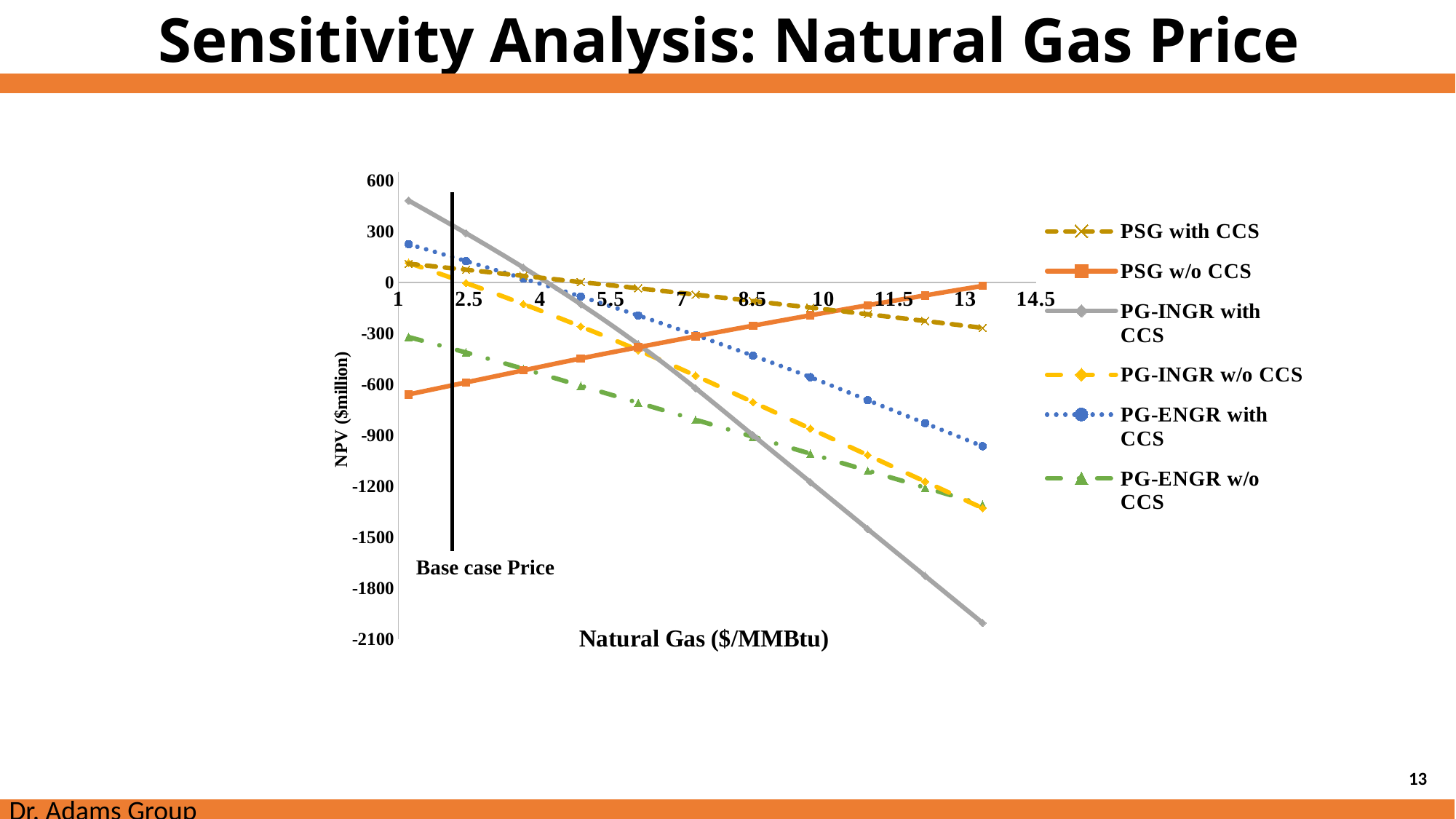
Which series has the lowest NPV at a natural gas price of 13 $/MMBtu? PG-INGR with CCS At a natural gas price of 13 $/MMBtu, which has the larger NPV: PG-ENGR with CCS or PG-INGR with CCS? PG-ENGR with CCS What kind of chart is shown on the slide? line chart Does the NPV for PG-INGR with CCS rise or fall as the natural gas price increases? fall Is the NPV for PG-INGR with CCS at a natural gas price of 13 $/MMBtu greater or less than -1800? less Does the NPV for PSG w/o CCS rise or fall as the natural gas price increases? rise Is the NPV for PG-ENGR with CCS at a natural gas price of 13 $/MMBtu greater or less than -900? less Is the NPV for PG-INGR with CCS at a natural gas price of 1 $/MMBtu greater or less than 300? greater What is the title of the x axis of the chart? Natural Gas ($/MMBtu) Which series has the highest NPV at a natural gas price of 13 $/MMBtu? PSG w/o CCS How many series does the legend list? 6 Which series has the highest NPV at a natural gas price of 1 $/MMBtu? PG-INGR with CCS